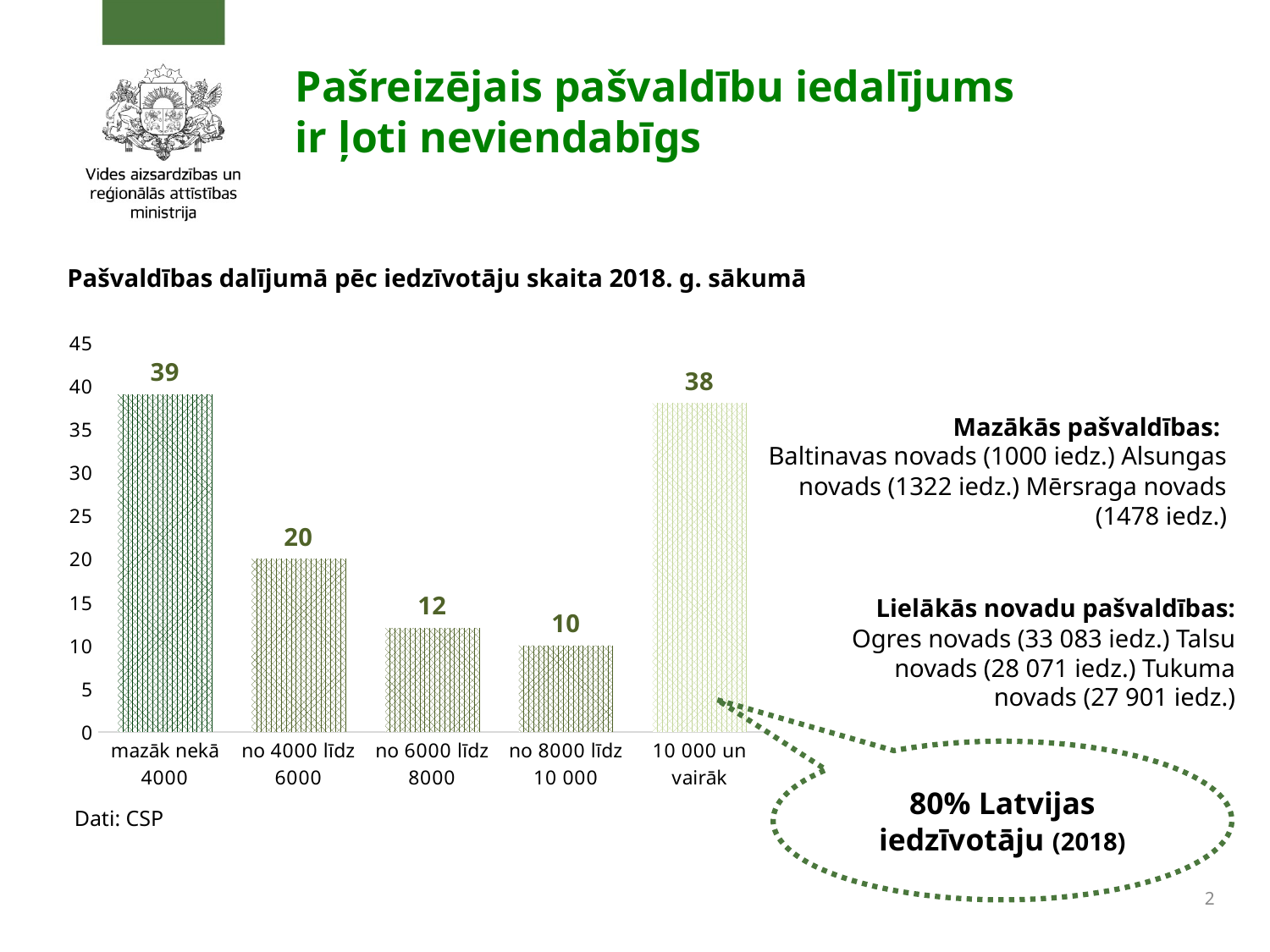
Which is larger, the value for 'no 4000 līdz 6000' or the value for 'no 6000 līdz 8000'? no 4000 līdz 6000 What is the value for the 'mazāk nekā 4000' category? 39 What kind of chart is shown on the slide? bar chart What is the difference between the values for 'no 6000 līdz 8000' and 'no 8000 līdz 10 000'? 2 What is the difference between the values for 'mazāk nekā 4000' and 'no 4000 līdz 6000'? 19 Is the value for 'no 4000 līdz 6000' greater or less than 15? greater What is the title of the chart? Pašvaldības dalījumā pēc iedzīvotāju skaita 2018. g. sākumā What is the value for the '10 000 un vairāk' category? 38 Which category has the highest value? mazāk nekā 4000 What is the value for the 'no 6000 līdz 8000' category? 12 How many categories are shown on the x axis? 5 Which category has the lowest value? no 8000 līdz 10 000